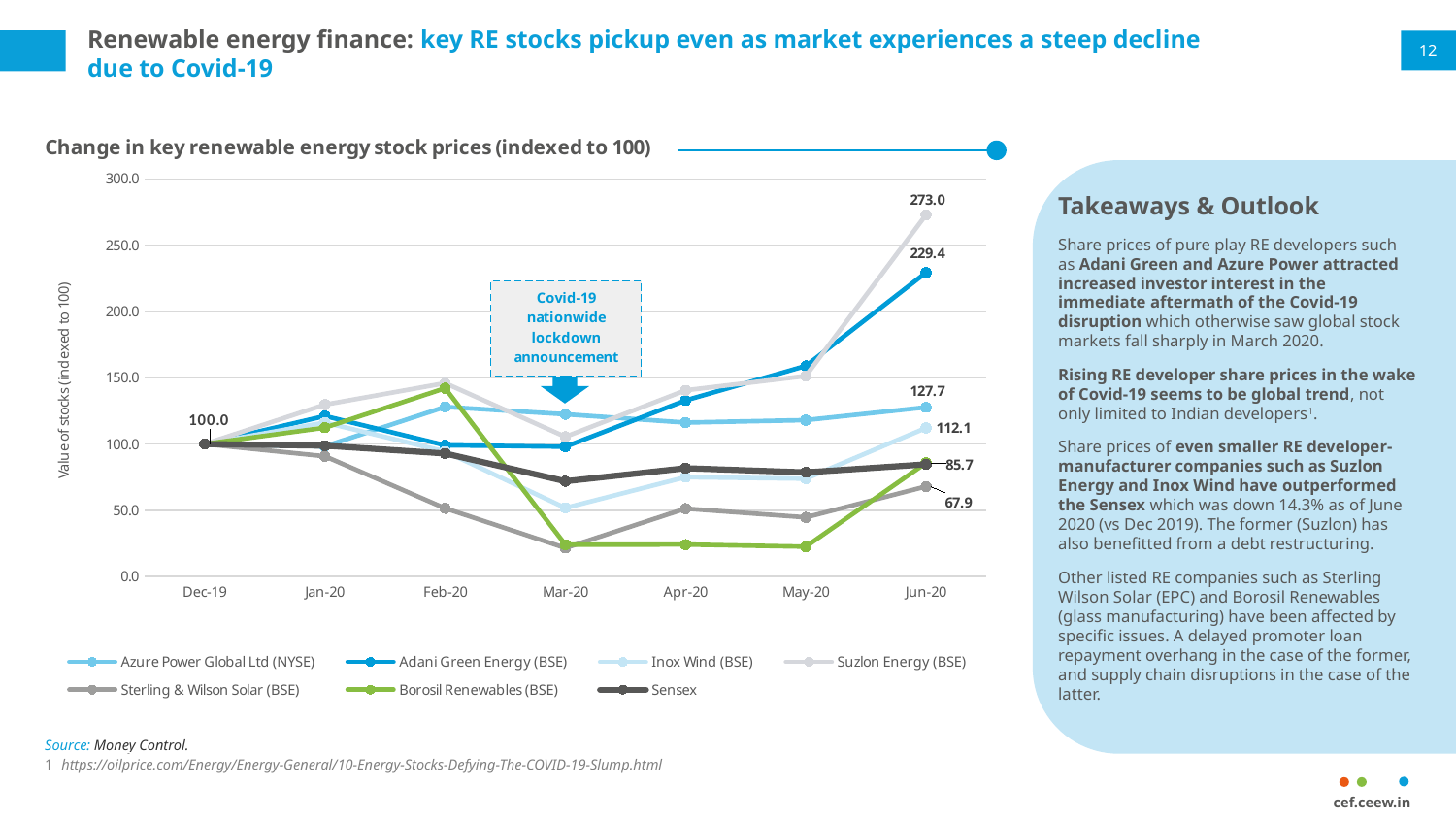
In Jun-20, which is higher: Azure Power Global Ltd (NYSE) or Inox Wind (BSE)? Azure Power Global Ltd (NYSE) Is the value for Borosil Renewables (BSE) in Mar-20 greater or less than 50.0? less Which series has the highest value in Jun-20? Suzlon Energy (BSE) How many series does the legend of the chart list? 7 What kind of chart is shown on the slide? Line chart What is the indexed value of Adani Green Energy (BSE) in Jun-20? 229.4 What is the indexed value of Suzlon Energy (BSE) in Jun-20? 273.0 What is the difference between the Jun-20 values of Suzlon Energy (BSE) and Adani Green Energy (BSE)? 43.6 Which series has the lowest value in Jun-20? Sterling & Wilson Solar (BSE) How many months are shown on the x axis of the chart? 7 What event does the annotation box above Mar-20 on the chart refer to? Covid-19 nationwide lockdown announcement